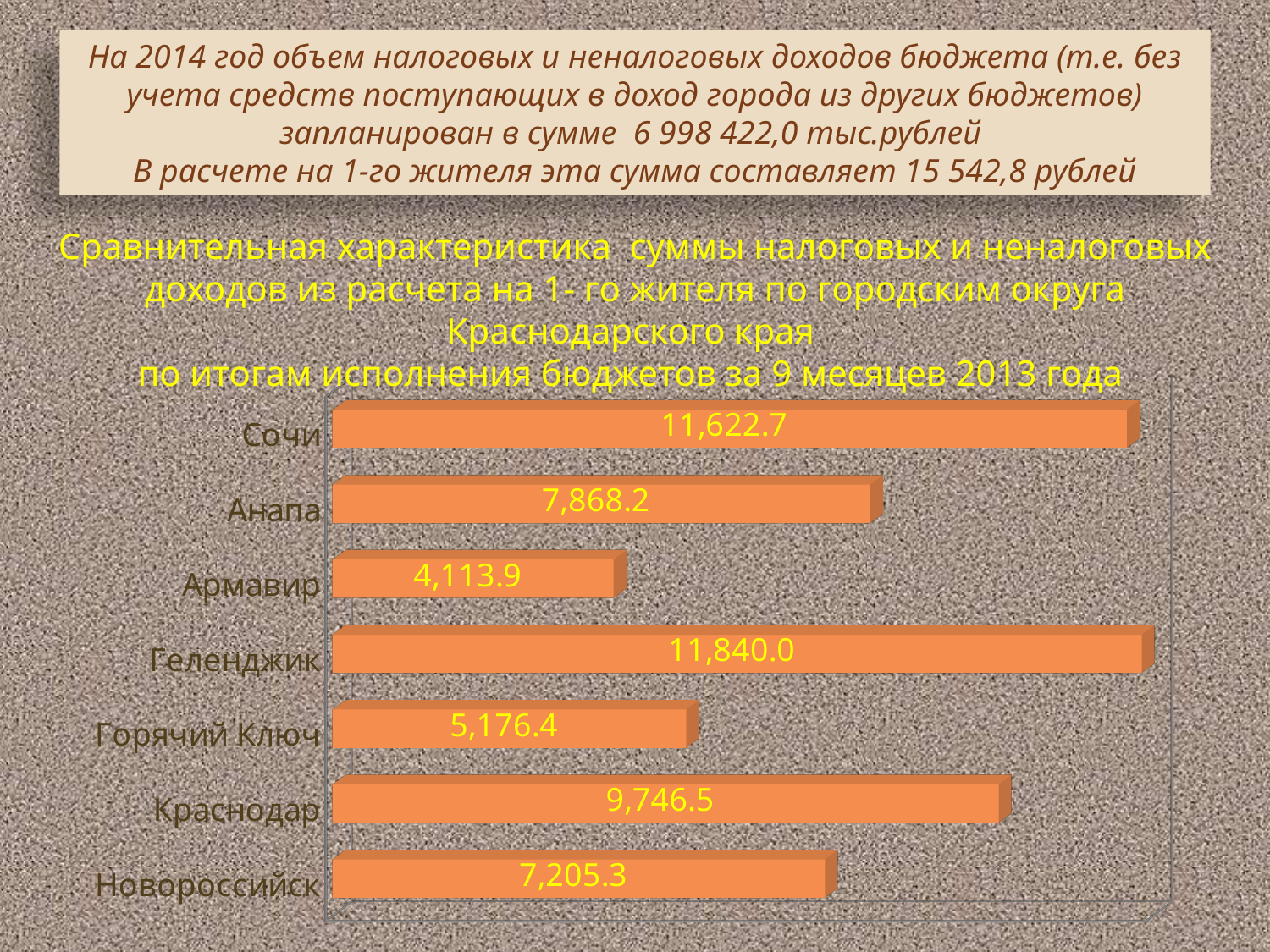
What is the value shown for Сочи? 11,622.7 Which city has the lowest value in the chart? Армавир Which city has the highest value in the chart? Геленджик What is the value shown for Горячий Ключ? 5,176.4 What is the difference between the values for Краснодар and Новороссийск? 2,541.2 What is the value shown for Новороссийск? 7,205.3 What is the difference between the values for Геленджик and Сочи? 217.3 What is the value shown for Геленджик? 11,840.0 How many cities are shown in the chart? 7 Which has a larger value, Анапа or Новороссийск? Анапа Which has a larger value, Армавир or Горячий Ключ? Горячий Ключ What type of chart is shown on the slide? Bar chart